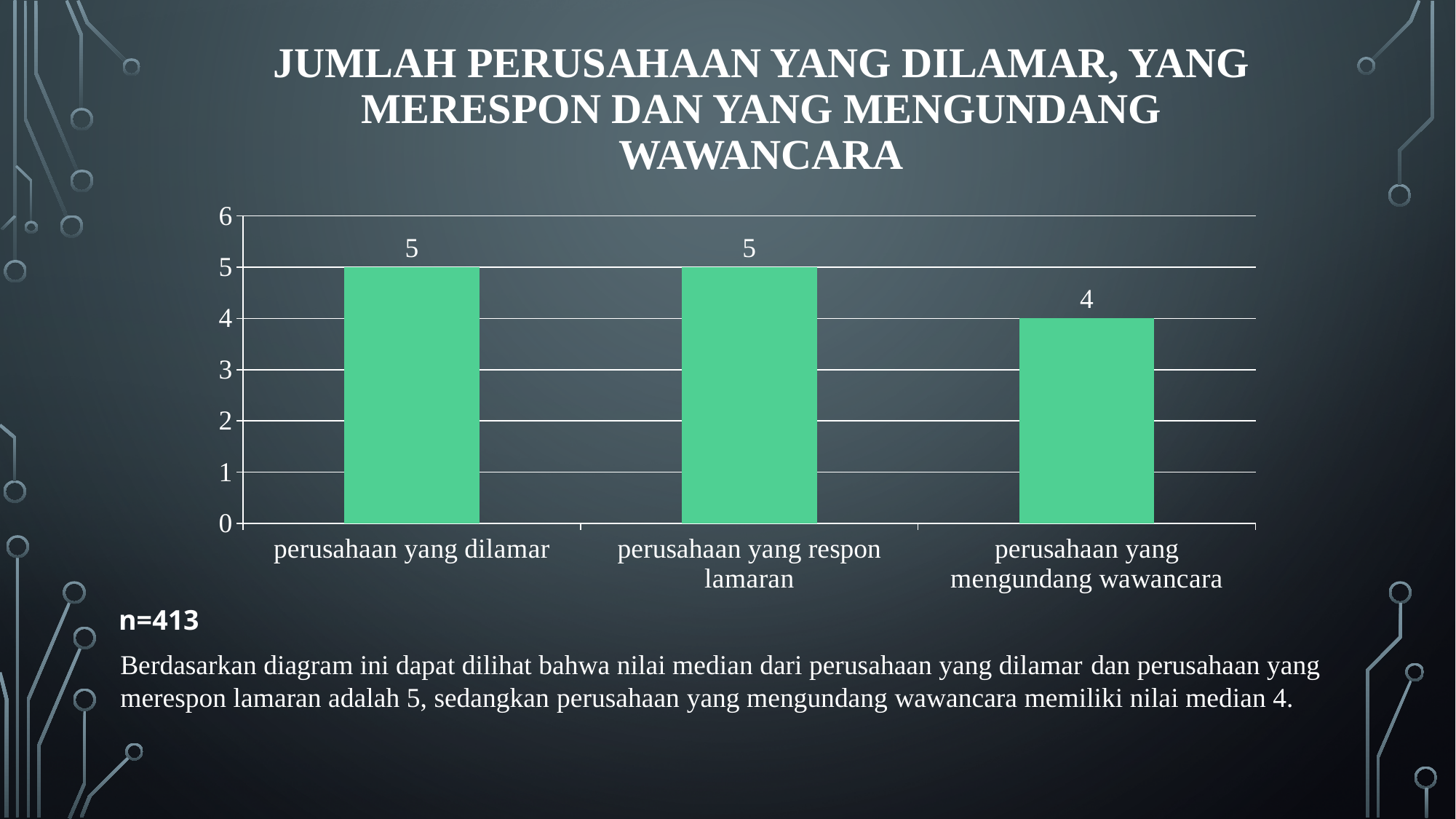
How many categories are shown on the x axis? 3 What is the difference between the value for "perusahaan yang dilamar" and the value for "perusahaan yang mengundang wawancara"? 1 Is the value for "perusahaan yang mengundang wawancara" greater or less than 5? less What colour are the bars in the chart? green What is the highest value shown on the y axis? 6 Which is larger: the value for "perusahaan yang respon lamaran" or the value for "perusahaan yang mengundang wawancara"? perusahaan yang respon lamaran Do the values rise or fall from the first category to the last category along the x axis? fall What kind of chart is shown on the slide? bar chart What is the value for "perusahaan yang respon lamaran"? 5 What is the value for "perusahaan yang dilamar"? 5 Which category has the lowest value? perusahaan yang mengundang wawancara What is the value for "perusahaan yang mengundang wawancara"? 4